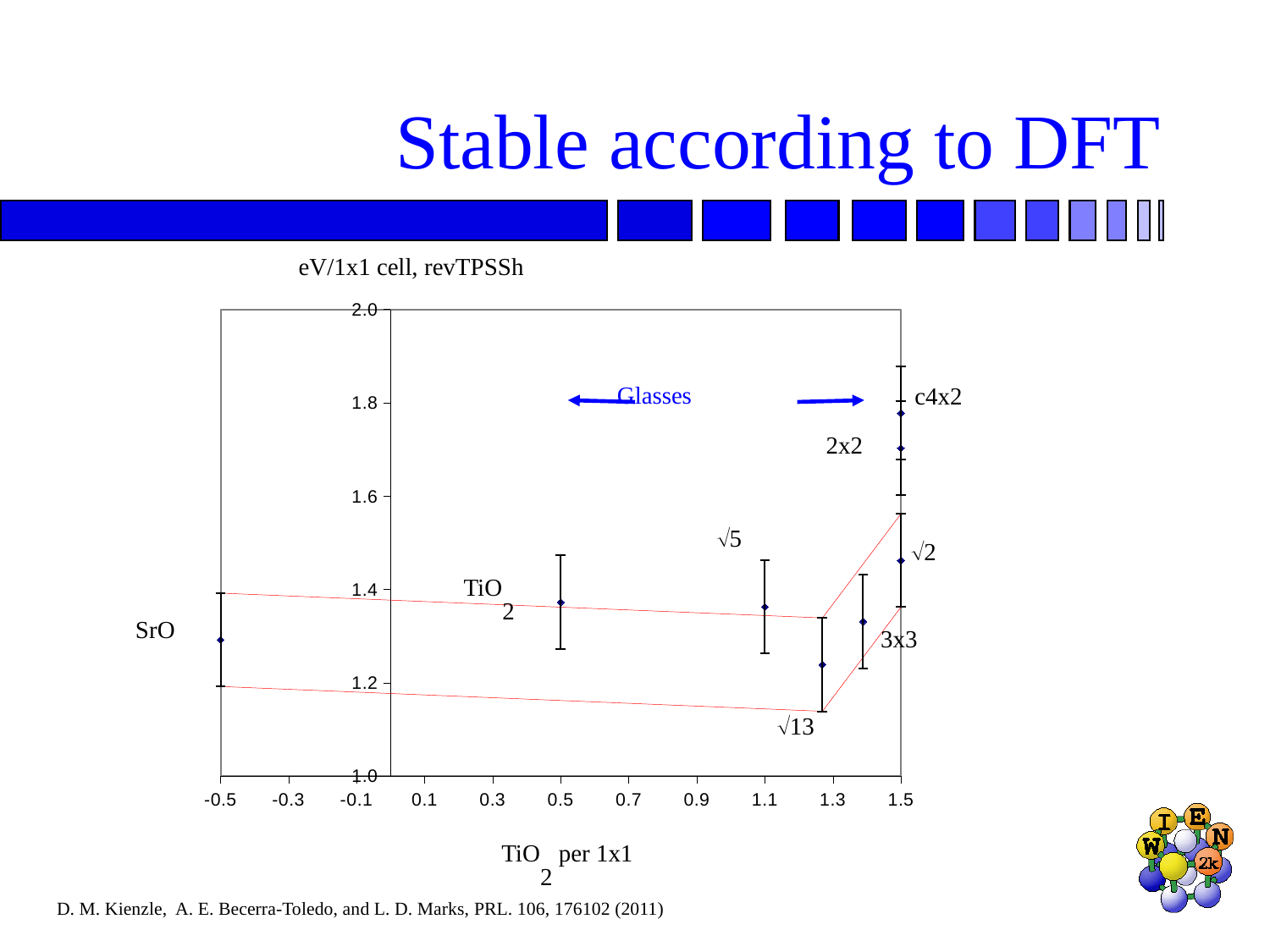
Which labeled point has the highest energy value on the chart? c4x2 Is the value for SrO greater or less than 1.4? less Is the value for 2x2 greater or less than 1.6? greater What is the label on the vertical axis of the chart? eV/1x1 cell, revTPSSh Which has the larger value, c4x2 or SrO? c4x2 Which labeled point has the lowest energy value on the chart? √13 Is the value for c4x2 greater or less than 1.6? greater What kind of chart is shown on the slide? Scatter chart with error bars Which has the larger value, 2x2 or 3x3? 2x2 How many labeled data points are plotted on the chart? 8